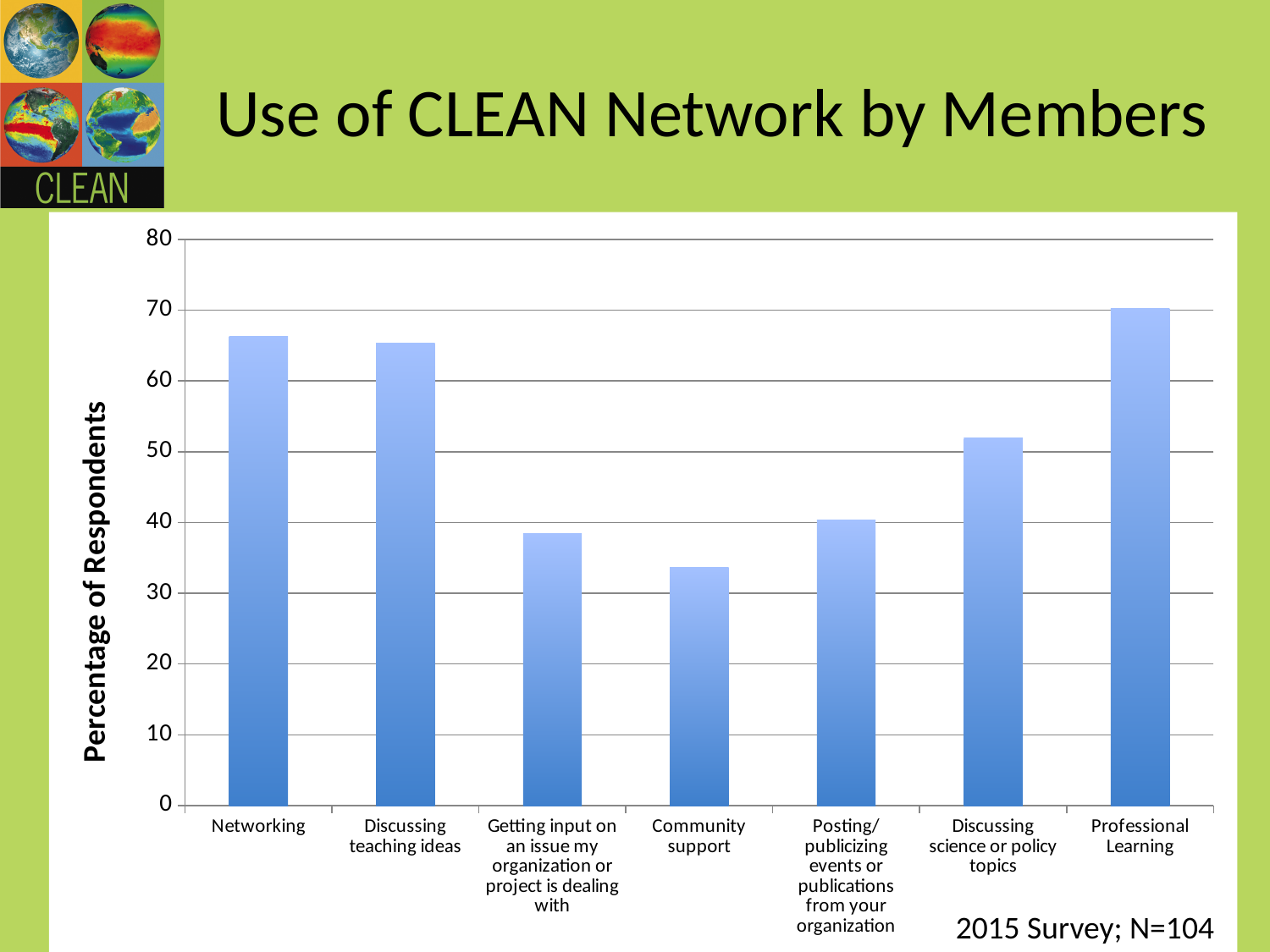
Which is larger, the value for Professional Learning or the value for Community support? Professional Learning Which category has the lowest percentage of respondents? Community support Is the value for Community support greater or less than 40? less Which is larger, the value for Discussing science or policy topics or the value for Discussing teaching ideas? Discussing teaching ideas Is the value for Discussing science or policy topics greater or less than 50? greater Which category has the highest percentage of respondents? Professional Learning Is the value for Posting/publicizing events or publications from your organization greater or less than 50? less What is the label on the vertical axis of the chart? Percentage of Respondents What kind of chart is shown on the slide? Bar chart How many categories are shown on the x axis of the chart? 7